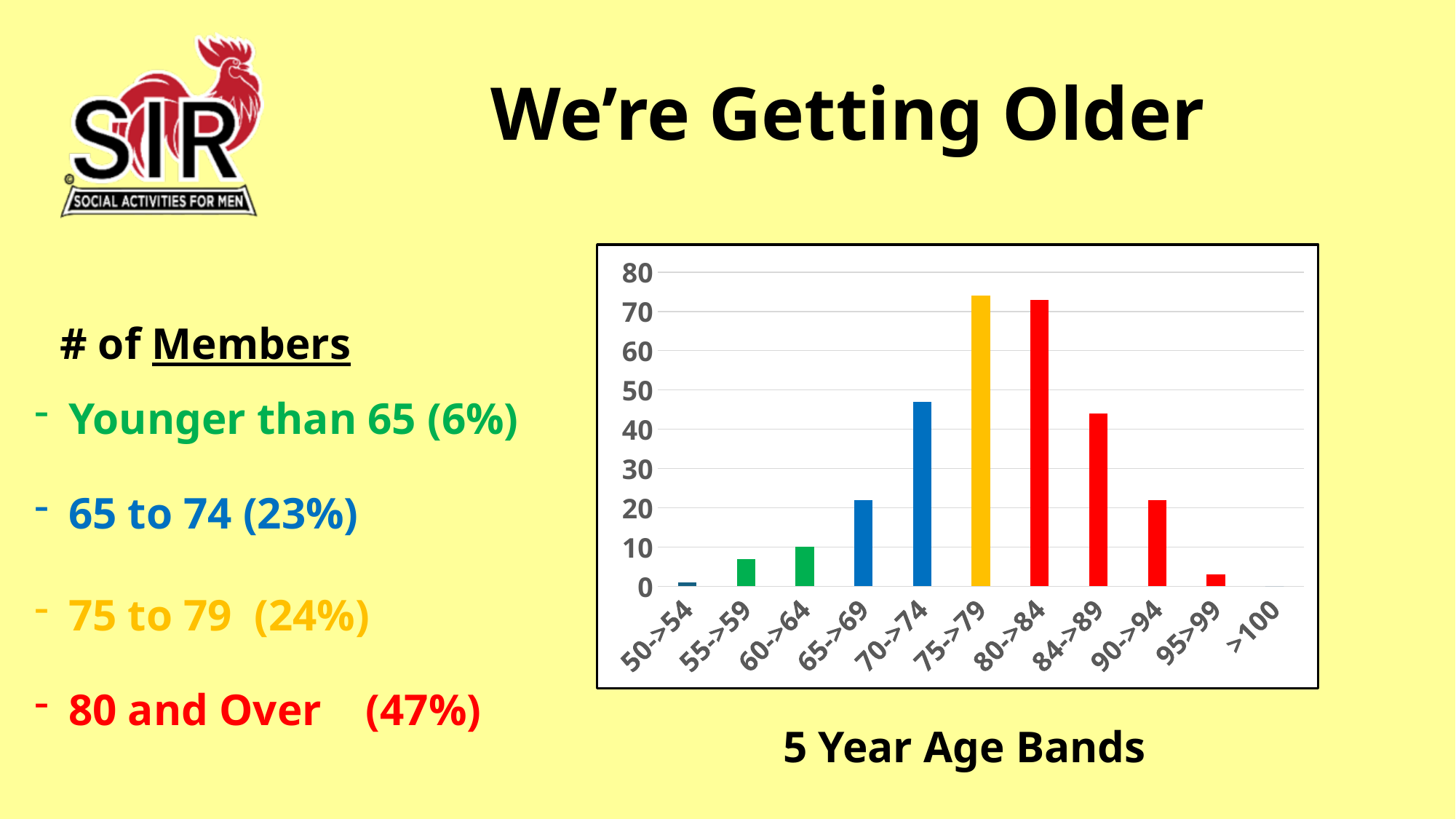
What kind of chart is shown on the slide? bar chart Is the value for the 84->89 age band greater or less than 40? greater Is the value for the 75->79 age band greater or less than 70? greater Is the value for the 95>99 age band greater or less than 10? less What label is shown beneath the chart describing the x axis? 5 Year Age Bands Do the values rise or fall along the x axis from 50->54 to 75->79? rise Which has the larger value, the 70->74 age band or the 65->69 age band? 70->74 Which has the larger value, the 84->89 age band or the 90->94 age band? 84->89 How many age-band categories are shown on the x axis of the chart? 11